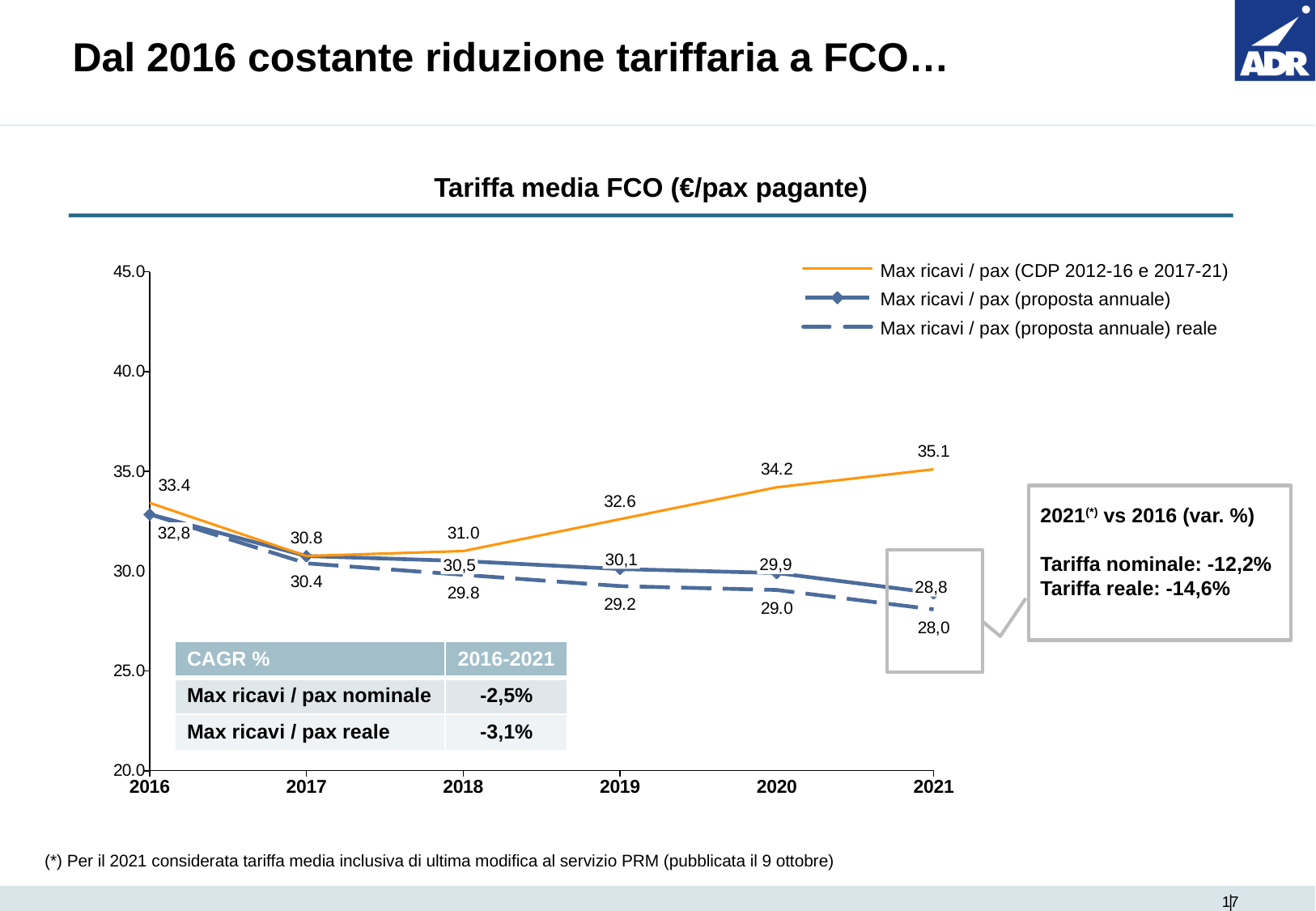
What type of chart is shown on the slide? line chart What is the value of the Max ricavi / pax (CDP 2012-16 e 2017-21) series in 2021? 35.1 Does the Max ricavi / pax (proposta annuale) series rise or fall from 2016 to 2021? fall How many years are shown on the x axis of the chart? 6 What is the value of the Max ricavi / pax (proposta annuale) series in 2016? 32,8 In 2020, which series has the higher value: Max ricavi / pax (CDP 2012-16 e 2017-21) or Max ricavi / pax (proposta annuale)? Max ricavi / pax (CDP 2012-16 e 2017-21) By how much does the Max ricavi / pax (CDP 2012-16 e 2017-21) value in 2021 exceed its value in 2016? 1.7 What is the difference between the 2017 and 2021 values of the Max ricavi / pax (proposta annuale) reale series? 2.4 How many series does the chart legend list? 3 In which year does the Max ricavi / pax (CDP 2012-16 e 2017-21) series reach its highest value? 2021 In which year does the Max ricavi / pax (CDP 2012-16 e 2017-21) series reach its lowest value? 2017 What is the value of the Max ricavi / pax (proposta annuale) reale series in 2021? 28,0